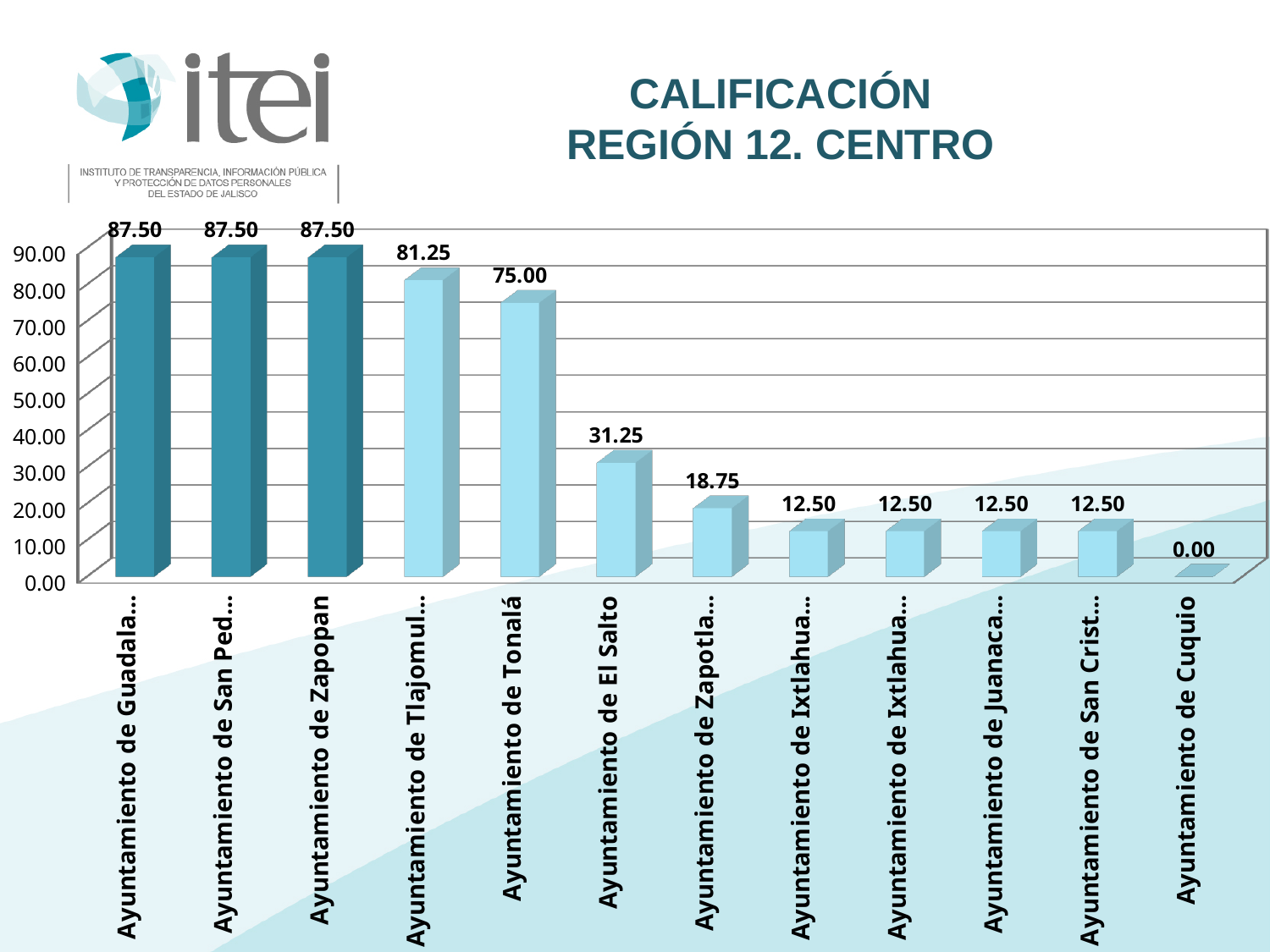
How many bars are shown in the chart? 12 What is the value for Ayuntamiento de Tonalá? 75.00 Which is larger, the value for Ayuntamiento de Tonalá or Ayuntamiento de El Salto? Ayuntamiento de Tonalá What is the value for Ayuntamiento de Cuquio? 0.00 How many bars have a value of 87.50? 3 What kind of chart is shown on the slide? bar chart What is the value for Ayuntamiento de Zapopan? 87.50 What is the value for Ayuntamiento de El Salto? 31.25 What is the difference between the values for Ayuntamiento de Tonalá and Ayuntamiento de El Salto? 43.75 What is the difference between the values for Ayuntamiento de Zapopan and Ayuntamiento de Tonalá? 12.50 Which category has the lowest value? Ayuntamiento de Cuquio Do the values rise or fall from left to right along the x axis? fall